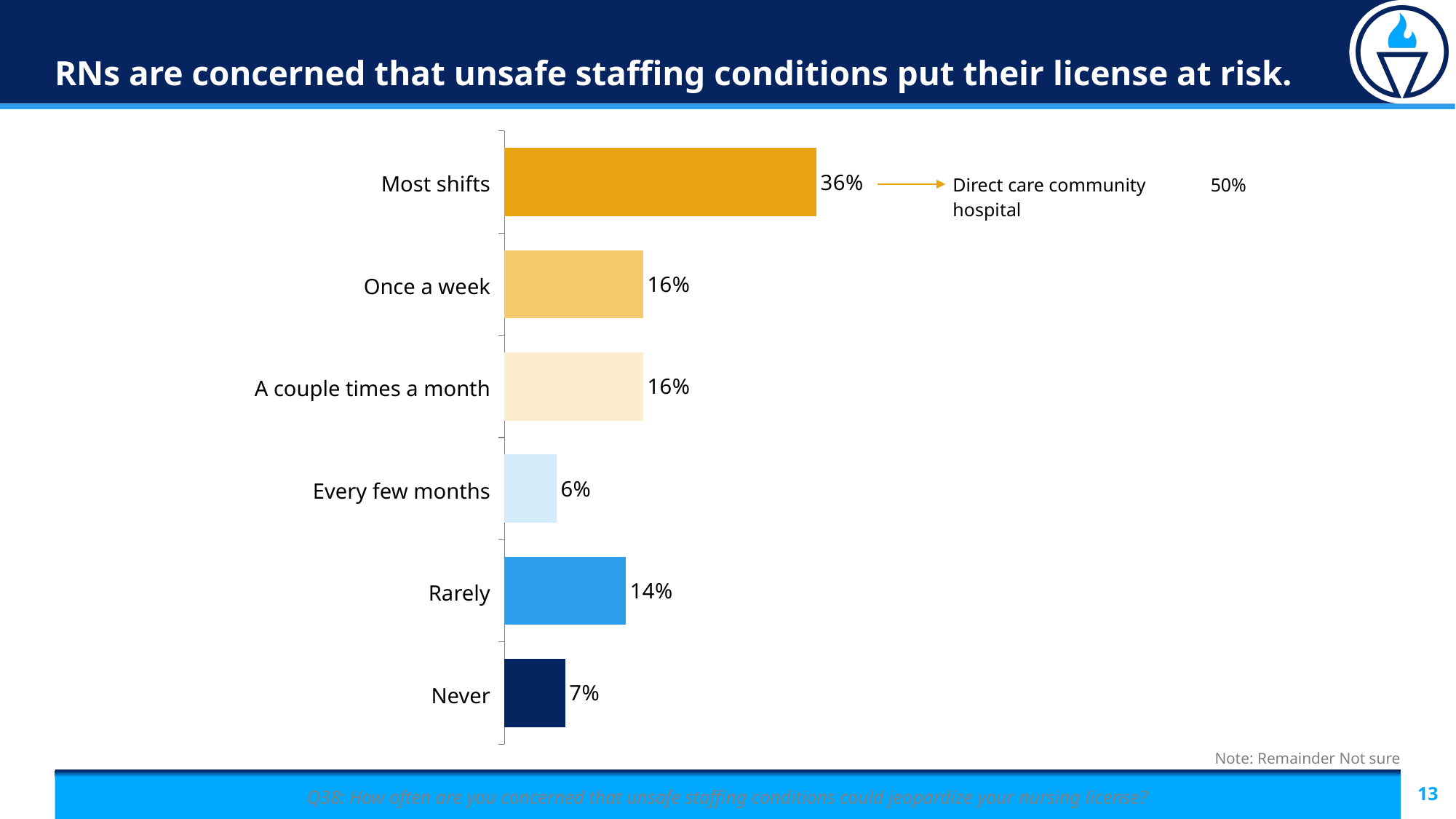
What is the value for 'Every few months'? 6% What value is given for direct care community hospital RNs in the callout next to the 'Most shifts' bar? 50% Which category has the highest value? Most shifts Which category has the lowest value? Every few months Which is larger, the value for 'Rarely' or the value for 'Never'? Rarely How many categories are shown in the chart? 6 What kind of chart is shown on the slide? Bar chart What is the value for 'Never'? 7% What is the combined value of 'Once a week' and 'A couple times a month'? 32% What is the difference between the values for 'Most shifts' and 'Once a week'? 20 percentage points What is the value for 'Rarely'? 14% What percentage of RNs are concerned most shifts? 36%